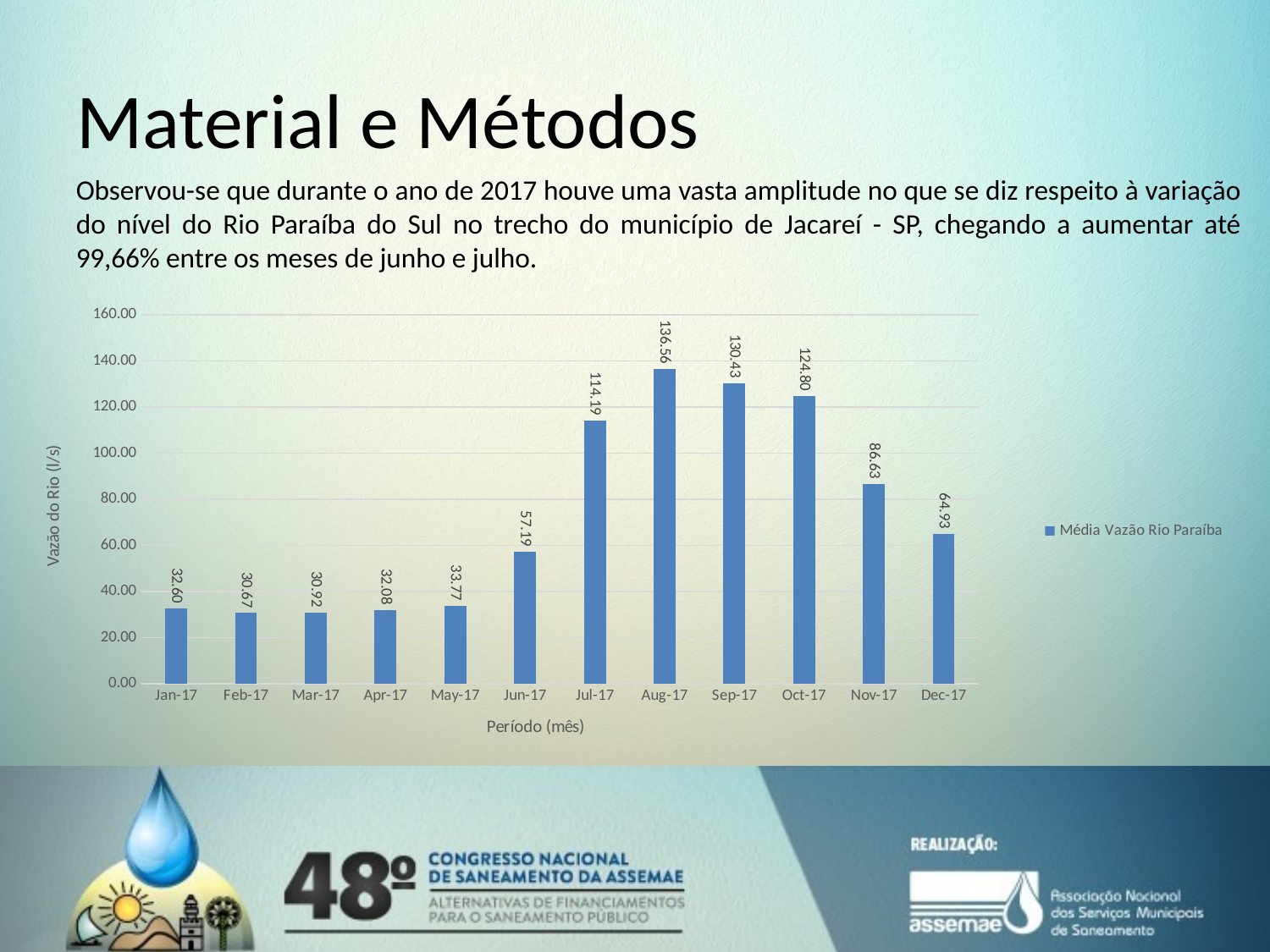
What is the label of the y axis? Vazão do Rio (l/s) Which month has the lowest value? Feb-17 What is the difference between the values for Jul-17 and Jun-17? 57.00 What is the value for Dec-17? 64.93 How many series does the legend list? 1 Which month has the highest value? Aug-17 How many months are shown on the x axis? 12 What kind of chart is shown on the slide? bar chart What is the value for Aug-17? 136.56 Which is larger, the value for Sep-17 or the value for Oct-17? Sep-17 What is the value for Jun-17? 57.19 Is the value for Nov-17 greater or less than 80.00? greater